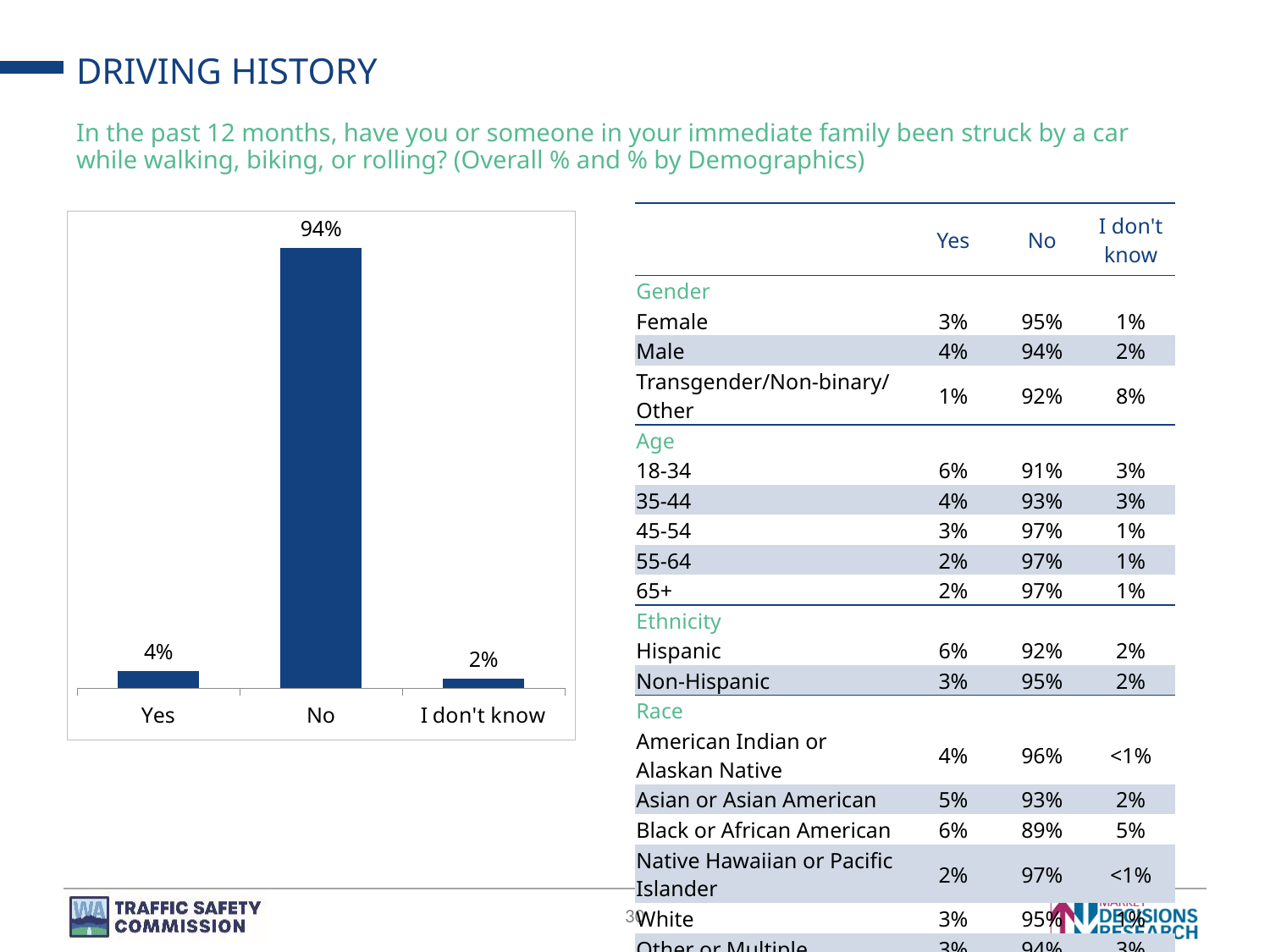
What percentage of respondents answered "I don't know" in the bar chart? 2% How many response categories are shown in the bar chart? 3 What is the difference between the "Yes" and "I don't know" percentages in the bar chart? 2 percentage points What is the difference between the "No" and "Yes" percentages in the bar chart? 90 percentage points Which response category has the highest value in the bar chart? No What percentage of respondents answered "Yes" in the bar chart? 4% What is the total of the three percentages shown in the bar chart? 100% What type of chart is shown on the slide? Bar chart Which response category has the lowest value in the bar chart? I don't know In the bar chart, which is larger: the value for "Yes" or the value for "I don't know"? Yes What percentage of respondents answered "No" in the bar chart? 94% What colour are the bars in the chart? Dark blue